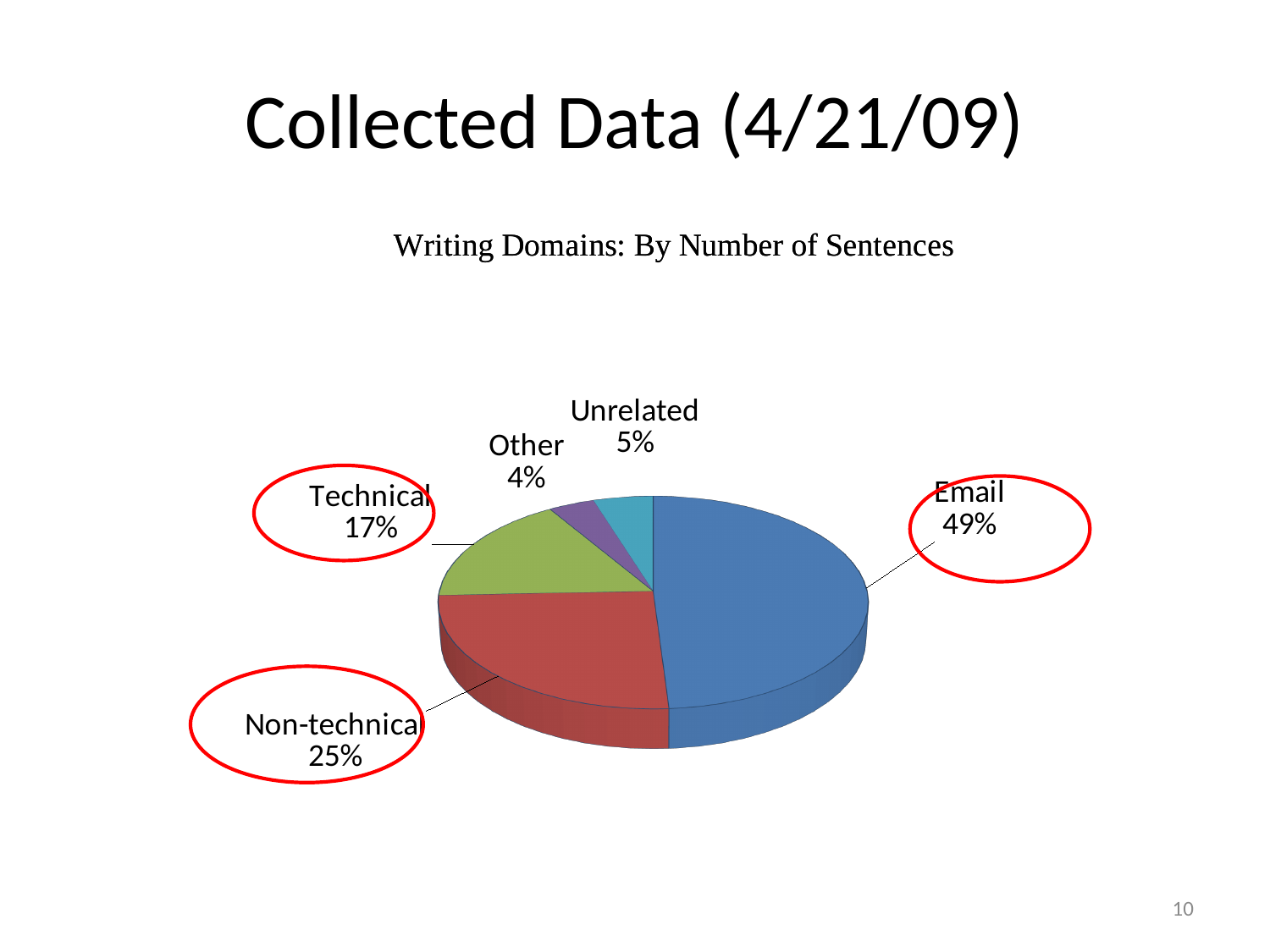
Which writing domain has the smallest share of sentences? Other What is the title of the chart? Writing Domains: By Number of Sentences What kind of chart is shown on the slide? Pie chart What percentage is shown for Technical? 17% What percentage is shown for Unrelated? 5% What is the difference in percentage points between Email and Non-technical? 24 What percentage is shown for Other? 4% What share of the pie does Email account for? 49% What percentage is shown for Non-technical? 25% Which writing domain has the largest share of sentences? Email How many slices does the pie chart have? 5 Which is larger, the share for Technical or the share for Non-technical? Non-technical